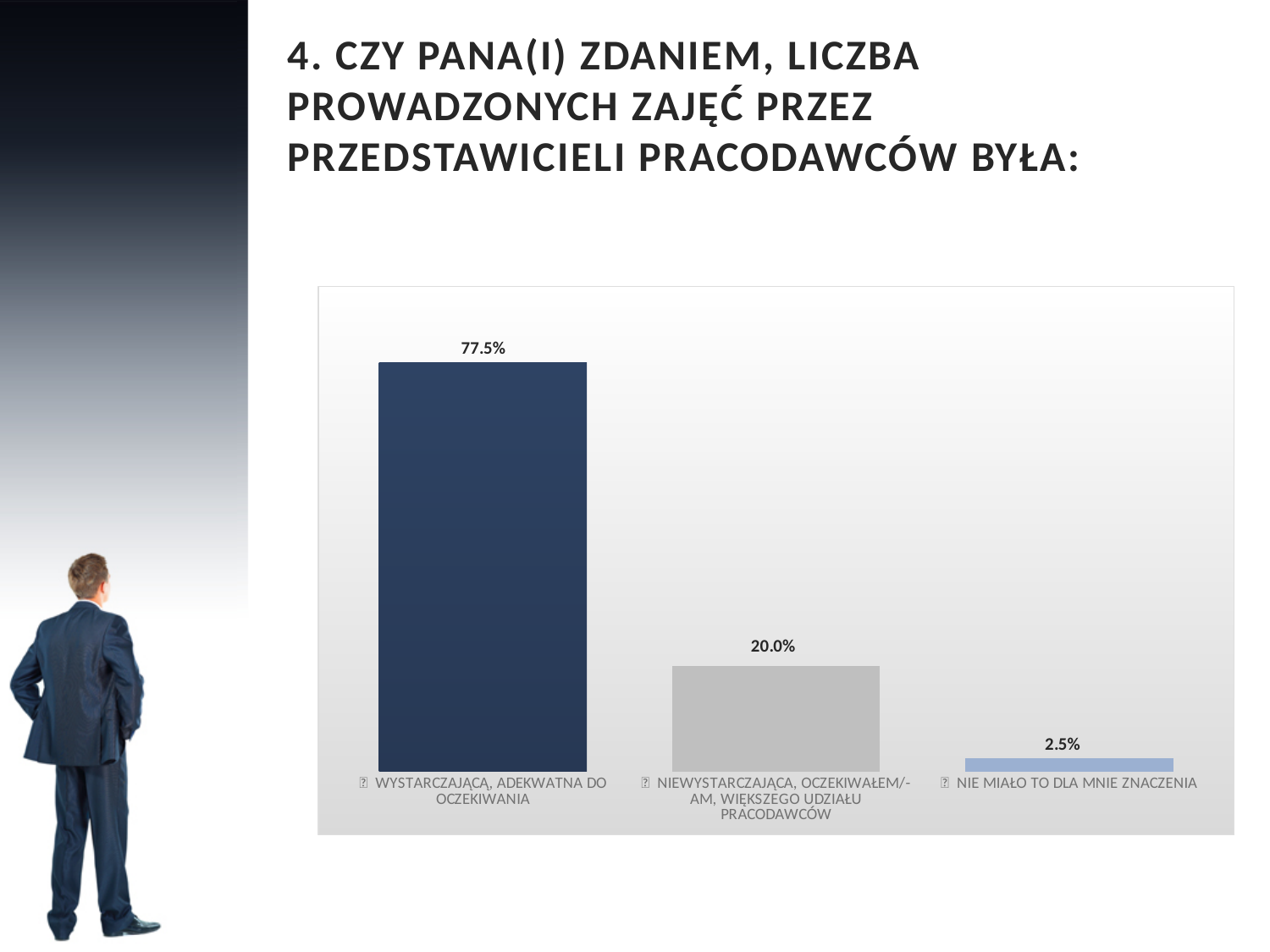
Which category has the lowest value? NIE MIAŁO TO DLA MNIE ZNACZENIA What is the value for the category "NIE MIAŁO TO DLA MNIE ZNACZENIA"? 2.5% Do the values rise or fall from left to right across the categories? Fall What is the value for the category "WYSTARCZAJĄCA, ADEKWATNA DO OCZEKIWANIA"? 77.5% What is the difference between the values for "NIEWYSTARCZAJĄCA, OCZEKIWAŁEM/-AM, WIĘKSZEGO UDZIAŁU PRACODAWCÓW" and "NIE MIAŁO TO DLA MNIE ZNACZENIA"? 17.5% What kind of chart is shown on the slide? Bar chart What colour is the bar for "WYSTARCZAJĄCA, ADEKWATNA DO OCZEKIWANIA"? Dark navy blue Which is larger: the value for "NIEWYSTARCZAJĄCA, OCZEKIWAŁEM/-AM, WIĘKSZEGO UDZIAŁU PRACODAWCÓW" or for "NIE MIAŁO TO DLA MNIE ZNACZENIA"? NIEWYSTARCZAJĄCA, OCZEKIWAŁEM/-AM, WIĘKSZEGO UDZIAŁU PRACODAWCÓW What is the difference between the values for "WYSTARCZAJĄCA, ADEKWATNA DO OCZEKIWANIA" and "NIEWYSTARCZAJĄCA, OCZEKIWAŁEM/-AM, WIĘKSZEGO UDZIAŁU PRACODAWCÓW"? 57.5% Which category has the highest value? WYSTARCZAJĄCA, ADEKWATNA DO OCZEKIWANIA How many categories are shown in the chart? 3 What is the value for the category "NIEWYSTARCZAJĄCA, OCZEKIWAŁEM/-AM, WIĘKSZEGO UDZIAŁU PRACODAWCÓW"? 20.0%